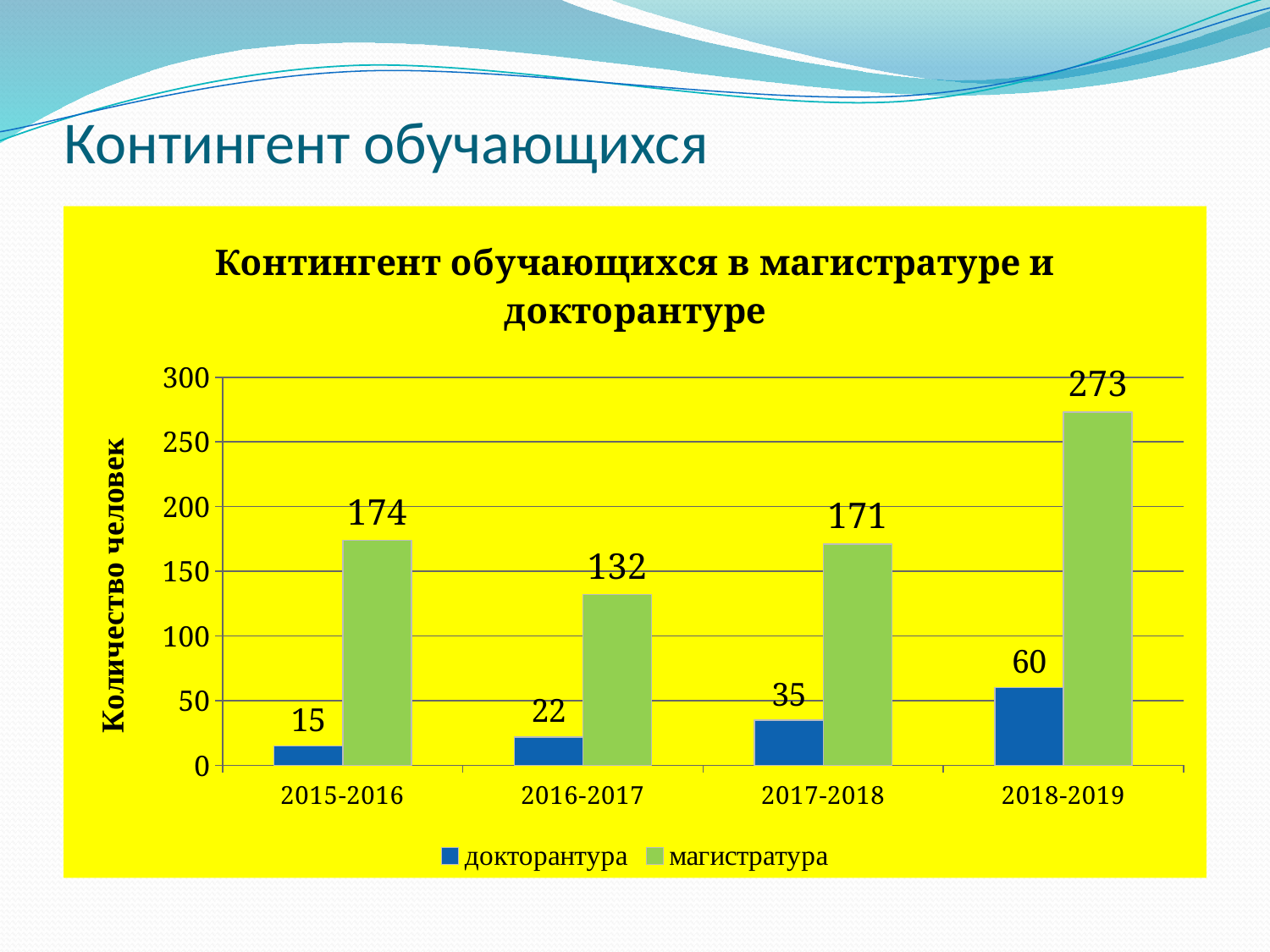
What is the value for магистратура in 2016-2017? 132 What kind of chart is shown on the slide? bar chart Which year has the highest value for докторантура? 2018-2019 What is the value for магистратура in 2018-2019? 273 How many series does the legend list? 2 Which year has the lowest value for магистратура? 2016-2017 Is the value for магистратура in 2018-2019 greater or less than 250? greater What is the difference between the магистратура values for 2018-2019 and 2017-2018? 102 What is the label of the vertical axis? Количество человек What is the value for докторантура in 2016-2017? 22 How many year categories are shown on the x axis? 4 Which is larger: магистратура in 2015-2016 or магистратура in 2017-2018? магистратура in 2015-2016